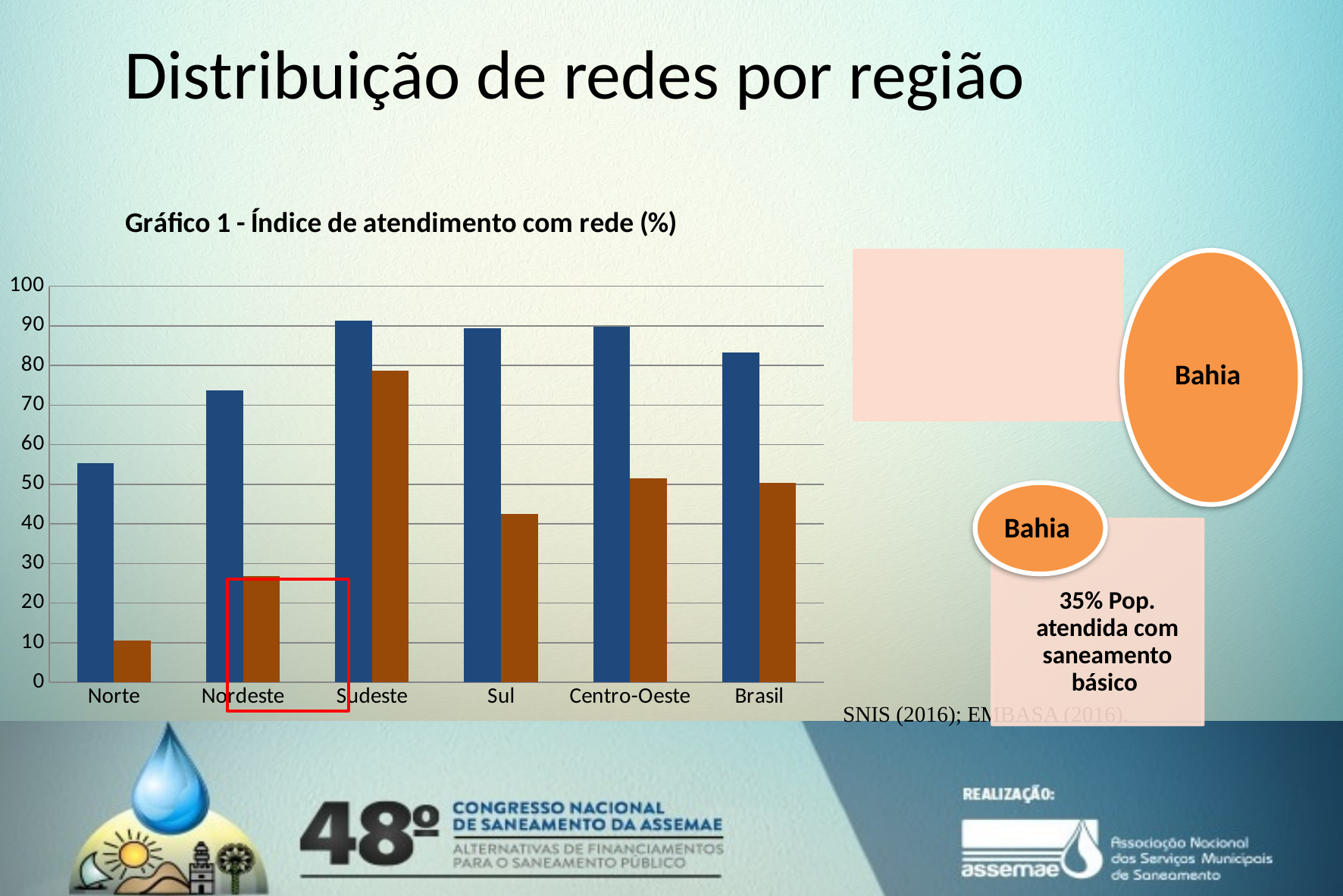
How many categories are shown on the x axis of the chart? 6 What kind of chart is Gráfico 1? bar chart Which category has the highest brown bar? Sudeste Which category has the lowest brown bar? Norte Is the blue bar for Brasil greater or less than 80? greater Which category has the lowest blue bar? Norte Is the blue bar for Norte greater or less than 50? greater What is the title of the chart? Gráfico 1 - Índice de atendimento com rede (%) Is the brown bar for Sul greater or less than 50? less For Norte, which bar is larger, the blue one or the brown one? the blue one